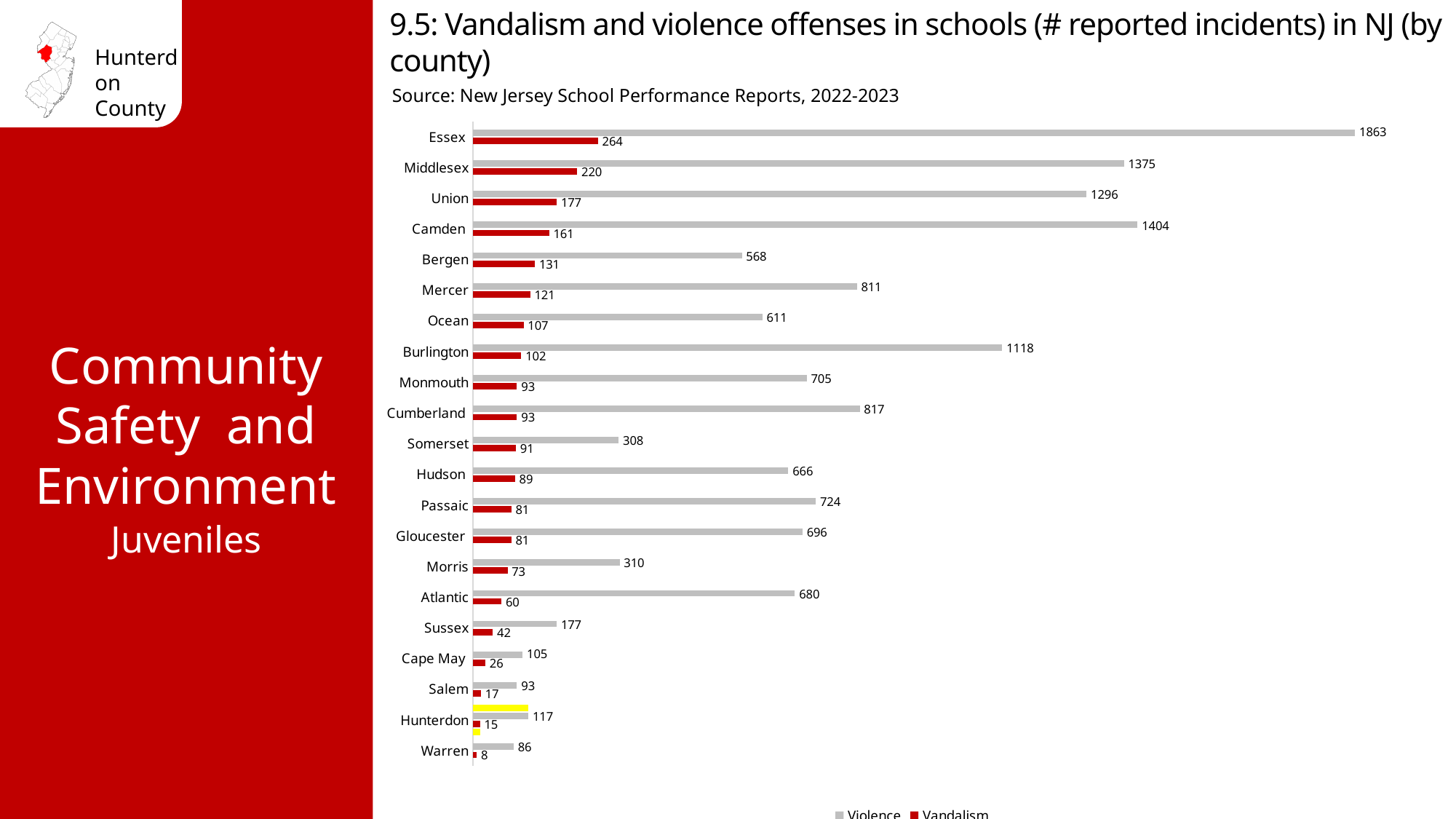
Which series is shown in red? Vandalism What is the number of reported violence incidents for Hunterdon? 117 How many counties are shown in the chart? 21 What type of chart is shown on the slide? Bar chart What is the difference between the violence values for Essex and Middlesex? 488 What is the number of reported vandalism incidents for Hunterdon? 15 Which county has the lowest number of vandalism incidents? Warren What is the total of violence and vandalism incidents for Warren? 94 Which county has more violence incidents, Camden or Union? Camden Which county has the highest number of violence incidents? Essex What is the violence value for Burlington? 1118 How many series does the legend list? 2